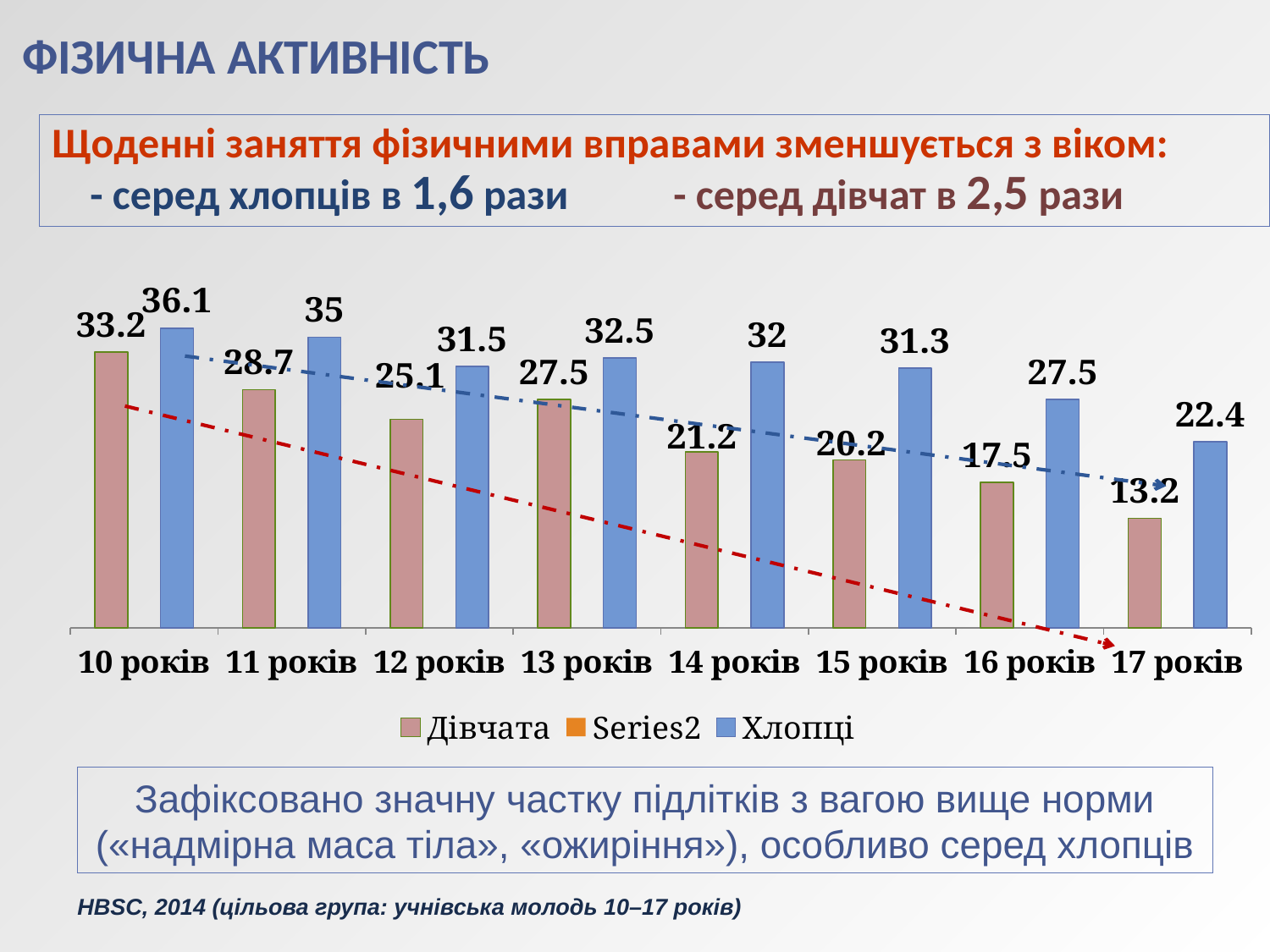
What is the value for Дівчата at 17 років? 13.2 At which age is the value for Дівчата the lowest? 17 років What is the value for Хлопці at 10 років? 36.1 Which is larger at 13 років: Дівчата or Хлопці? Хлопці What kind of chart is shown on the slide? bar chart What is the difference between Хлопці and Дівчата at 17 років? 9.2 How many series does the legend list? 3 What is the difference between Хлопці and Дівчата at 15 років? 11.1 How many age categories are shown on the x axis? 8 What is the value for Дівчата at 14 років? 21.2 What is the value for Хлопці at 16 років? 27.5 At which age is the value for Хлопці the highest? 10 років